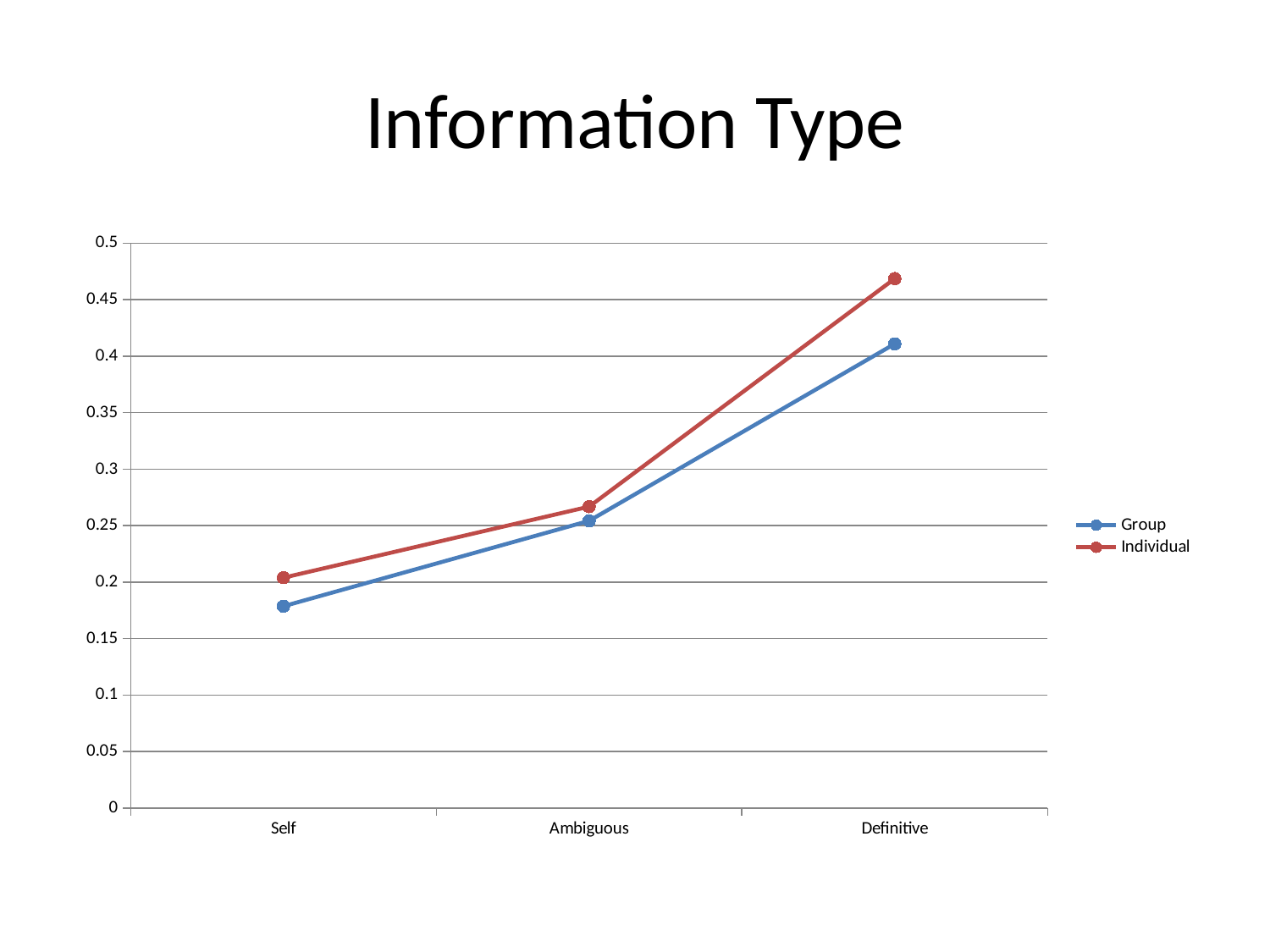
How many categories are shown on the x axis? 3 What kind of chart is shown on the slide? Line chart For the Individual series, which category has the lowest value? Self For the Group series, which category has the highest value? Definitive Is the value for Individual at Definitive greater or less than 0.45? greater Which two series are listed in the legend? Group and Individual Is the value for Group at Self greater or less than 0.2? less At Definitive, which series has the larger value, Group or Individual? Individual What is the title of the chart? Information Type Is the value for Individual at Ambiguous greater or less than 0.25? greater How many series does the legend list? 2 Do the values for the Individual series rise or fall from Self to Definitive? Rise